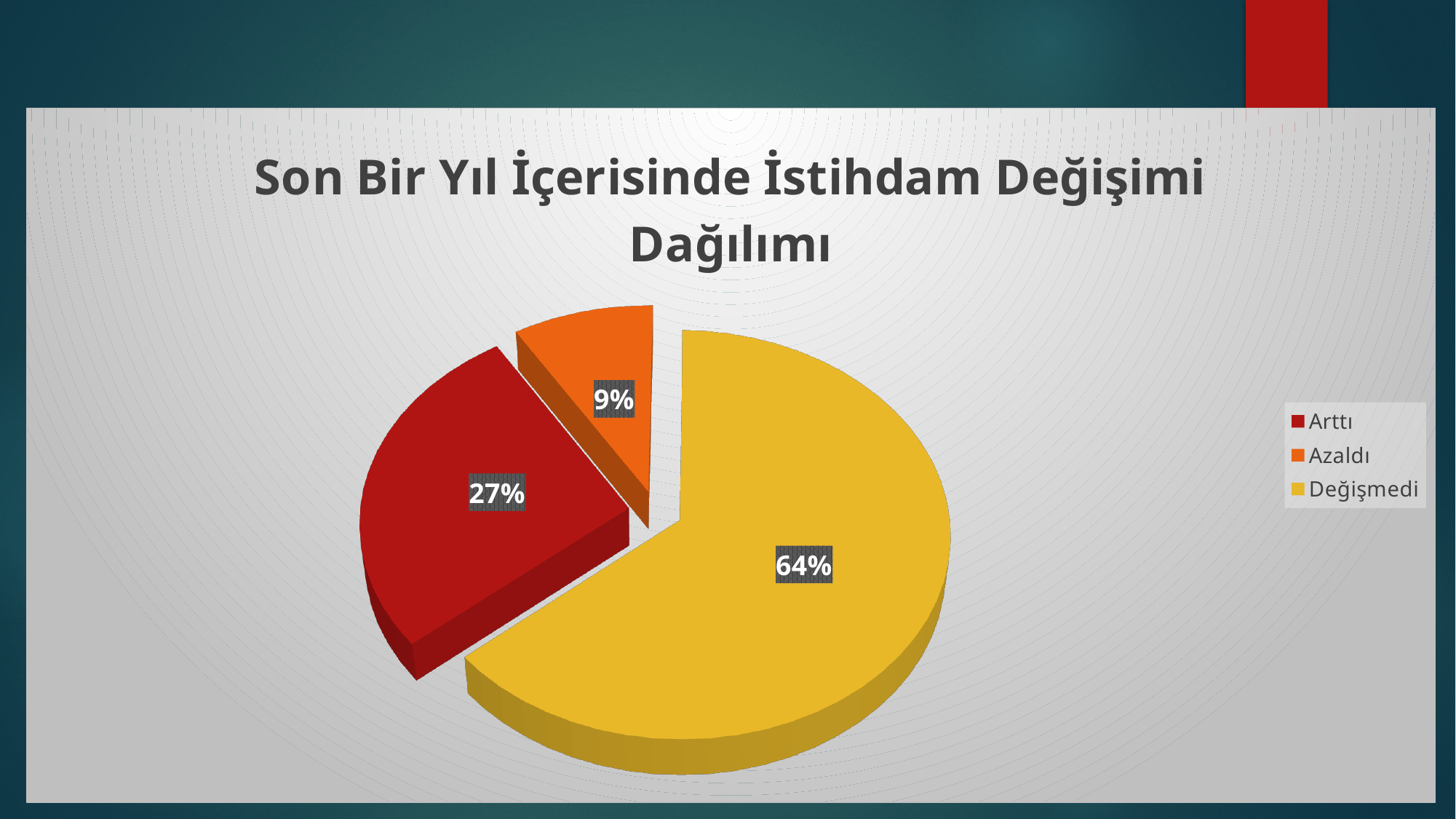
Which category has the smallest slice of the pie? Azaldı What colour is the Değişmedi slice? Yellow What share of the pie does Değişmedi have? 64% How many slices does the pie chart have? 3 What is the difference in percentage points between Değişmedi and Arttı? 37 Which category has the largest slice of the pie? Değişmedi What is the title of the chart? Son Bir Yıl İçerisinde İstihdam Değişimi Dağılımı What share of the pie does Azaldı have? 9% What kind of chart is shown on the slide? Pie chart What share of the pie does Arttı have? 27% What is the difference in percentage points between Arttı and Azaldı? 18 Which is larger, the share for Arttı or the share for Azaldı? Arttı